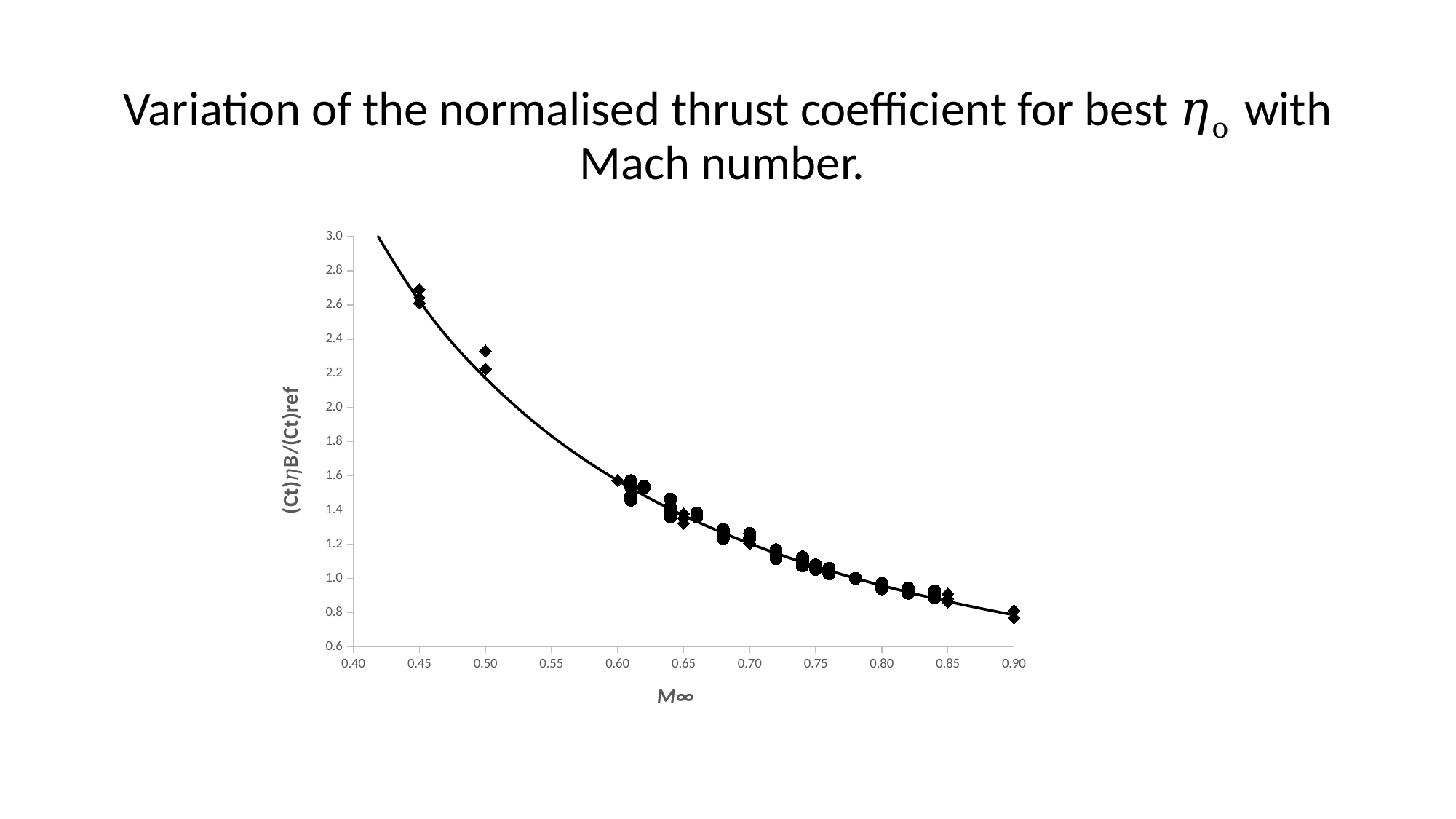
Are the plotted values at M∞ = 0.50 greater or less than 2.0? greater What kind of chart is shown on the slide? Scatter chart Do the plotted values rise or fall as the Mach number M∞ increases along the x axis? Fall Which has larger plotted values, M∞ = 0.45 or M∞ = 0.90? 0.45 What is the label on the y axis of the chart? (Ct)ηB/(Ct)ref At which Mach number are the lowest plotted values found? 0.90 Are the plotted values at M∞ = 0.90 greater or less than 1.0? less Are the plotted values at M∞ = 0.60 greater or less than 1.4? greater What is the label on the x axis of the chart? M∞ At which Mach number are the highest plotted values found? 0.45